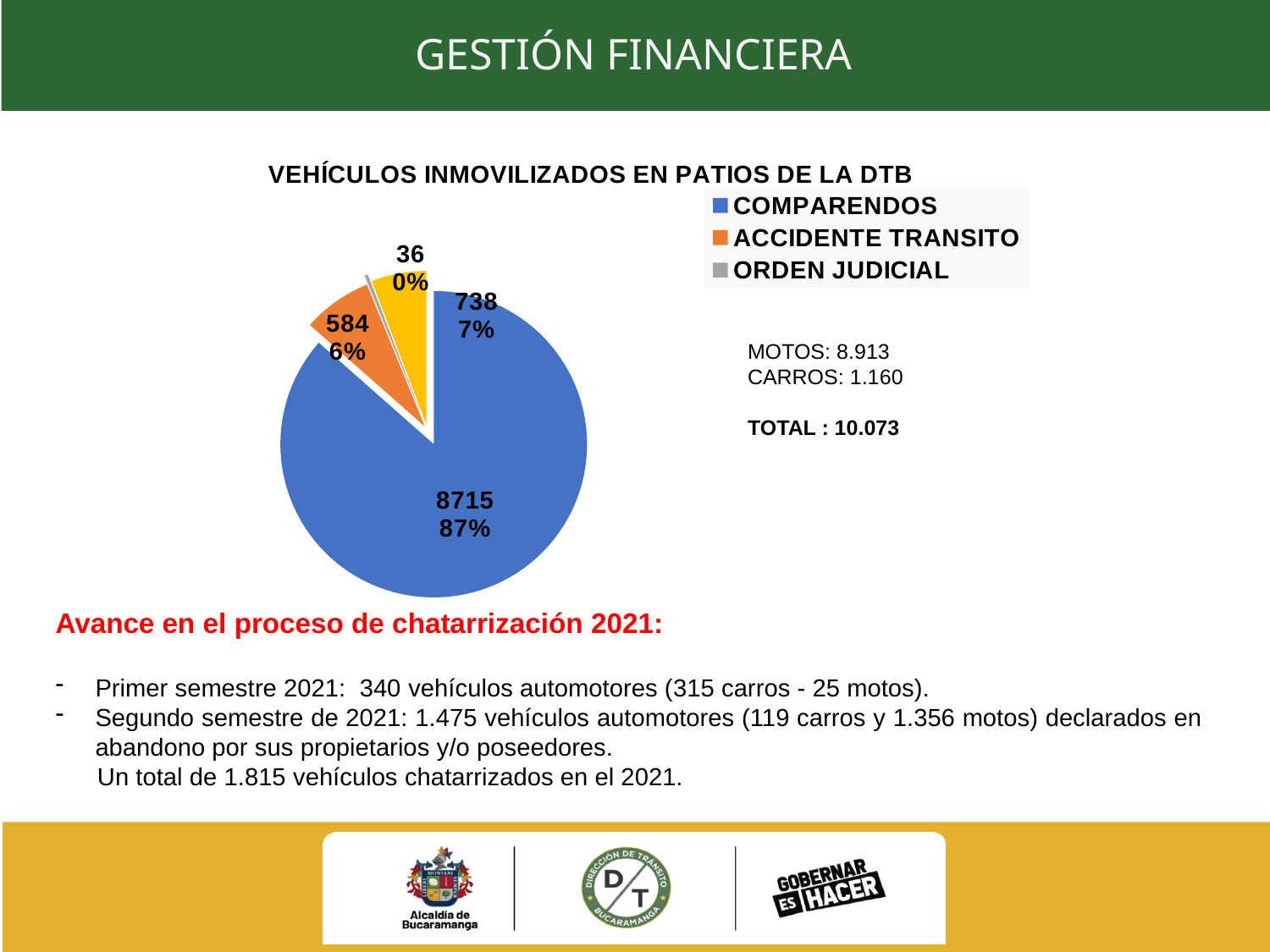
What is the difference between the values for ACCIDENTE TRANSITO and ORDEN JUDICIAL? 702 What is the title of the chart? VEHÍCULOS INMOVILIZADOS EN PATIOS DE LA DTB What type of chart is shown on the slide? Pie chart Which category has the largest slice of the pie? COMPARENDOS What share of the pie does COMPARENDOS represent? 87% What is the value for ORDEN JUDICIAL? 36 How many slices does the pie chart have? 4 What is the value for COMPARENDOS? 8715 What is the value for ACCIDENTE TRANSITO? 738 Which category has the smallest slice of the pie? ORDEN JUDICIAL How many entries does the chart legend list? 3 What share of the pie does ACCIDENTE TRANSITO represent? 7%